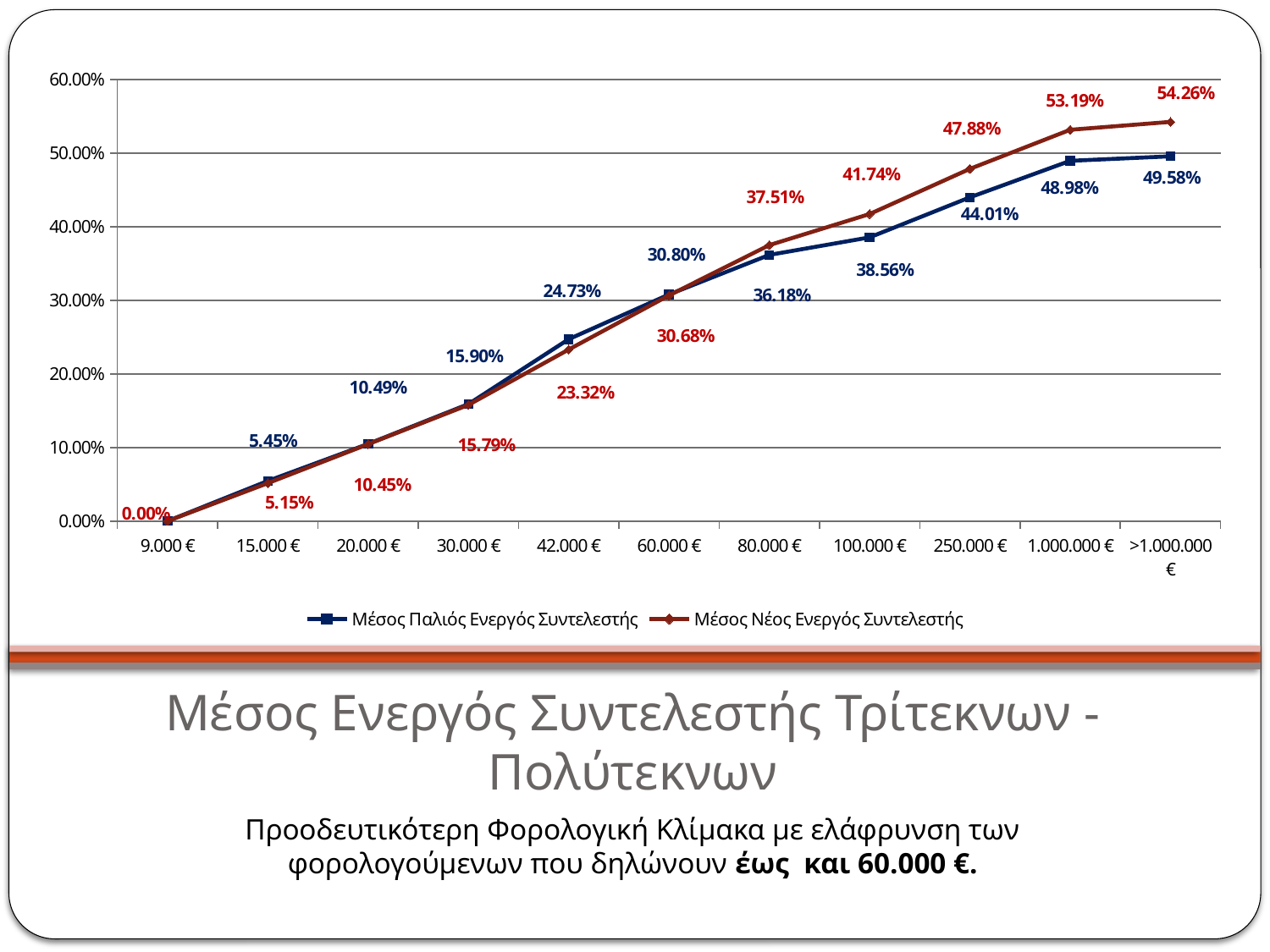
How many series does the legend list? 2 What is the difference between Μέσος Νέος Ενεργός Συντελεστής and Μέσος Παλιός Ενεργός Συντελεστής at >1.000.000 €? 4.68% At which income category is Μέσος Παλιός Ενεργός Συντελεστής lowest? 9.000 € What is the value of Μέσος Νέος Ενεργός Συντελεστής at 100.000 €? 41.74% What is the value of Μέσος Παλιός Ενεργός Συντελεστής at 250.000 €? 44.01% Do the values of Μέσος Νέος Ενεργός Συντελεστής rise or fall as income increases along the x axis? rise At 42.000 €, which series has the larger value, Μέσος Παλιός Ενεργός Συντελεστής or Μέσος Νέος Ενεργός Συντελεστής? Μέσος Παλιός Ενεργός Συντελεστής What is the value of Μέσος Νέος Ενεργός Συντελεστής at 30.000 €? 15.79% How many income categories are shown on the x axis? 11 At which income category does Μέσος Νέος Ενεργός Συντελεστής reach its highest value? >1.000.000 € What type of chart is shown on the slide? line chart Is the value of Μέσος Νέος Ενεργός Συντελεστής at 1.000.000 € greater or less than 50%? greater